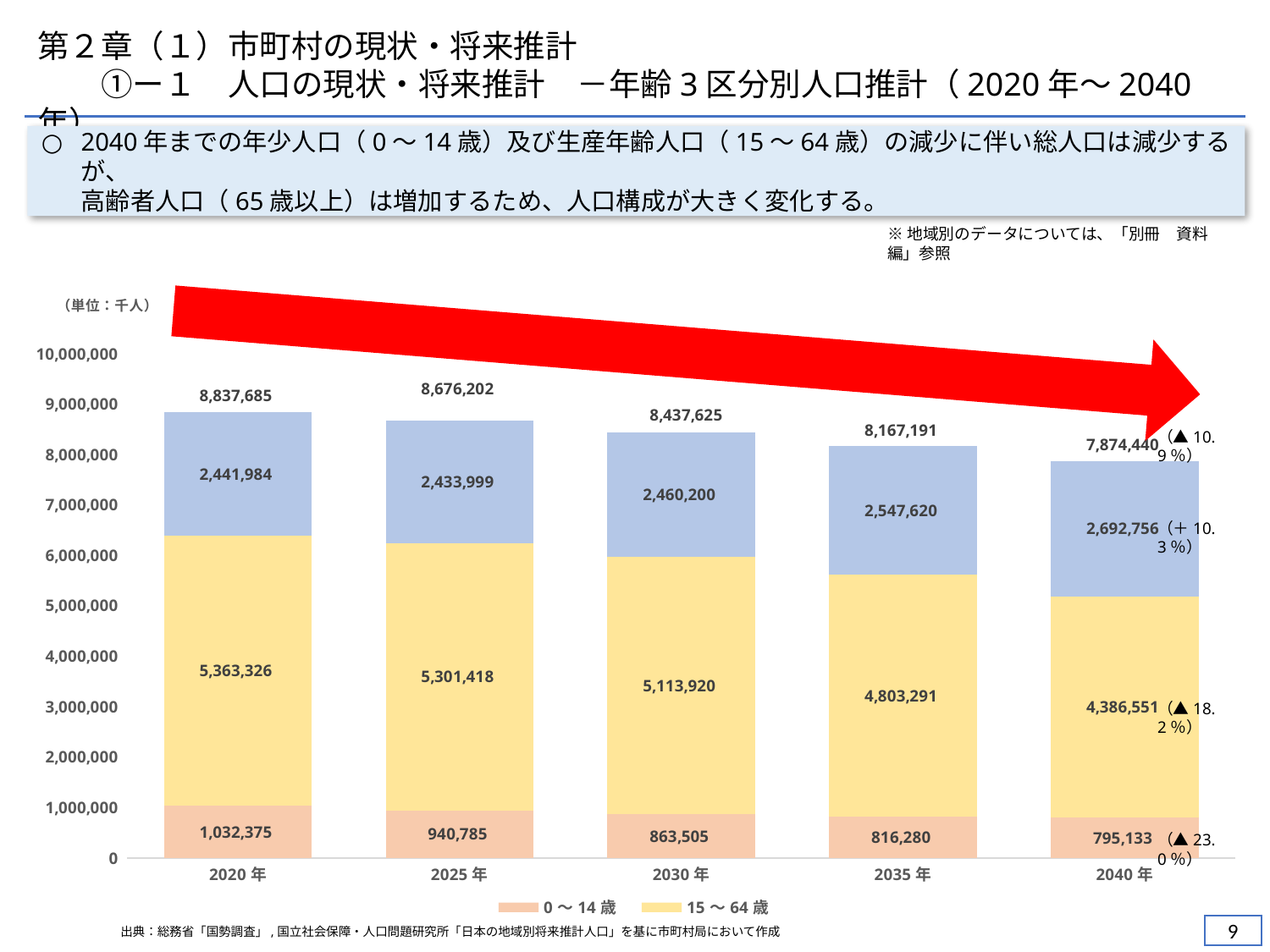
Which year has the highest total population? 2020年 What is the value of the top (blue) segment for 2035年? 2,547,620 What is the difference between the total population for 2020年 and 2040年? 963,245 Is the total population for 2040年 greater or less than 8,000,000? less Which is larger, the 15～64歳 value for 2025年 or for 2035年? 2025年 What is the value of the 15～64歳 segment for 2030年? 5,113,920 What is the total population value shown above the bar for 2020年? 8,837,685 What is the difference between the 0～14歳 values for 2020年 and 2040年? 237,242 Which year has the lowest 15～64歳 value? 2040年 What is the value of the 0～14歳 segment for 2040年? 795,133 How many years are shown on the x axis? 5 Do the total population values rise or fall from 2020年 to 2040年? fall